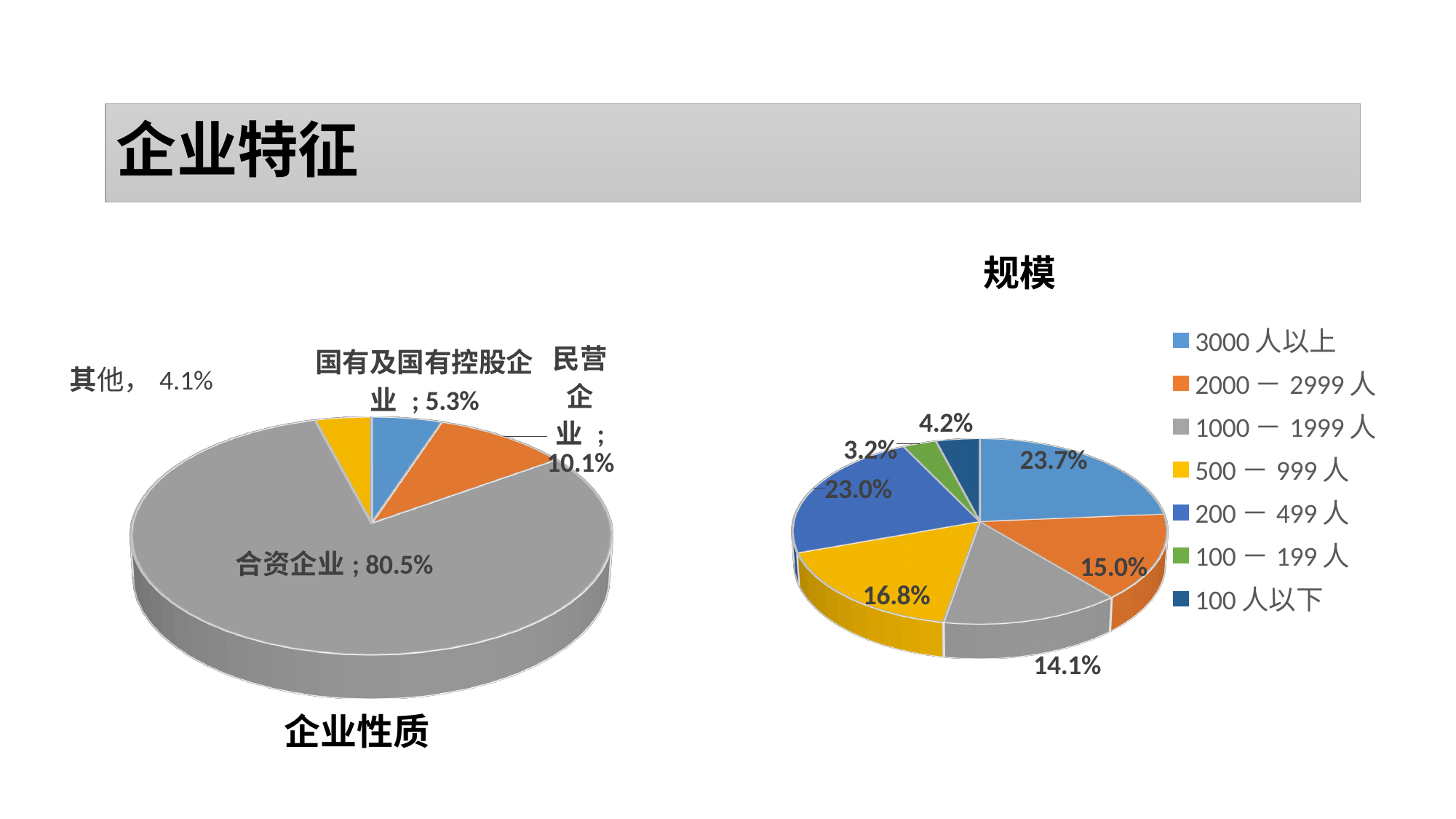
In the 企业性质 pie chart, what share is labelled for 合资企业? 80.5% In the 规模 pie chart, how many categories does the legend list? 7 In the 规模 pie chart, which is larger: the share for 2000－2999人 or the share for 1000－1999人? 2000－2999人 What type of chart is used for 规模? Pie chart In the 规模 pie chart, what share is labelled for 500－999人? 16.8% In the 企业性质 pie chart, how many slices are there? 4 In the 企业性质 pie chart, what share is labelled for 其他? 4.1% In the 企业性质 pie chart, what share is labelled for 民营企业? 10.1% In the 企业性质 pie chart, what is the difference between the shares of 民营企业 and 国有及国有控股企业? 4.8% In the 企业性质 pie chart, which category has the largest share? 合资企业 In the 规模 pie chart, what share is labelled for 3000人以上? 23.7% In the 规模 pie chart, which category has the smallest share? 100－199人